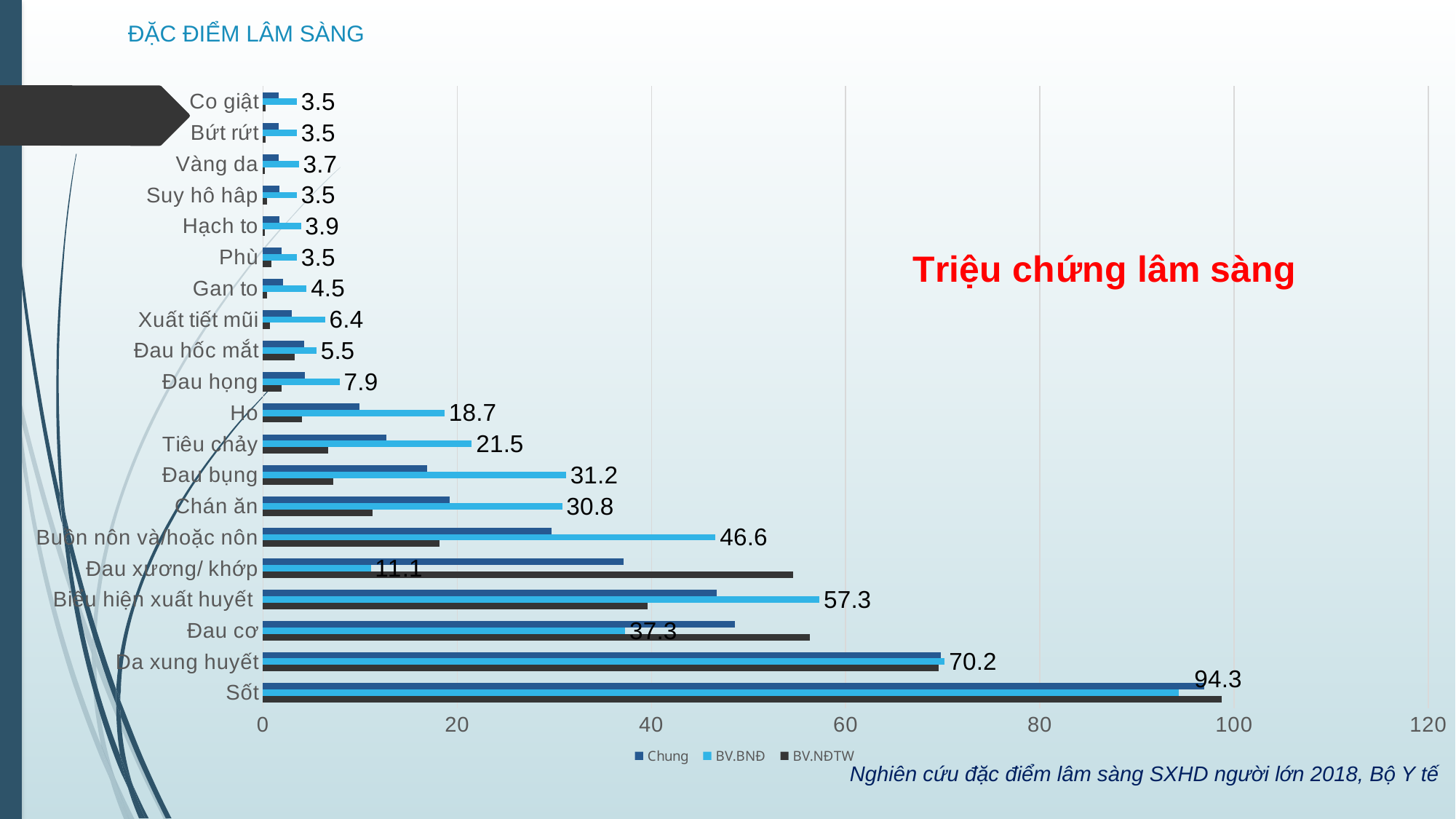
Which category has the highest BV.BNĐ value? Sốt What is the difference between the BV.BNĐ values for Da xung huyết and Đau cơ? 32.9 Is the Chung value for Sốt greater or less than 80? greater What is the difference between the BV.BNĐ values for Tiêu chảy and Ho? 2.8 What is the BV.BNĐ value for Sốt? 94.3 What is the BV.BNĐ value for Biểu hiện xuất huyết? 57.3 What kind of chart is shown on the slide? Bar chart What is the BV.BNĐ value for Buồn nôn và hoặc nôn? 46.6 Is the BV.NĐTW value for Đau xương/ khớp greater or less than 40? greater How many series does the legend list? 3 Which has the larger BV.BNĐ value, Đau bụng or Chán ăn? Đau bụng How many symptom categories are shown on the chart? 20